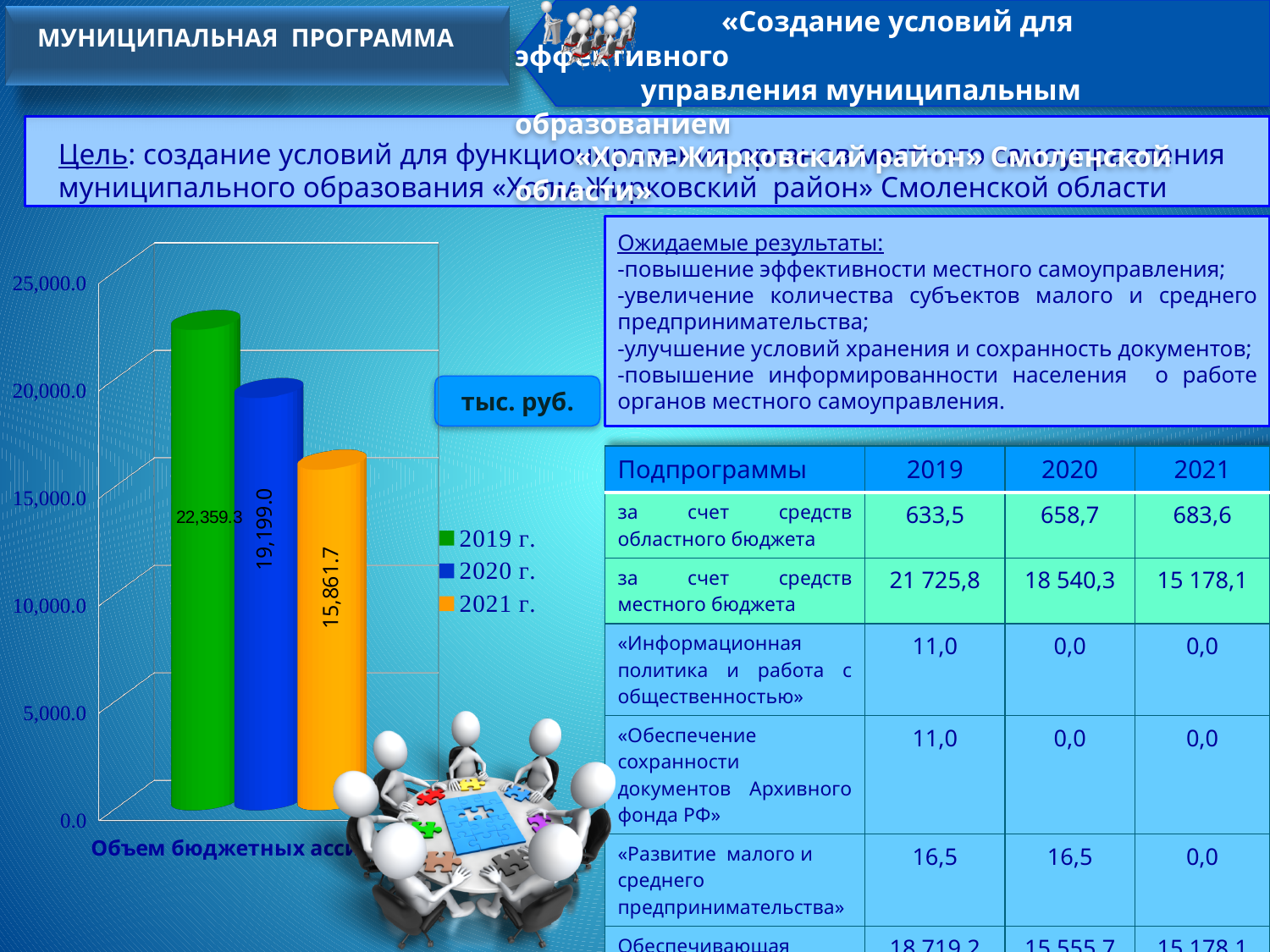
What is the value for 2021 г. in the bar chart? 15,861.7 What is the value for 2019 г. in the bar chart? 22,359.3 What is the value for 2020 г. in the bar chart? 19,199.0 What is the difference between the values for 2019 г. and 2020 г. in the bar chart? 3,160.3 How many bars are plotted in the bar chart? 3 Which is larger in the bar chart, the value for 2020 г. or the value for 2021 г.? 2020 г. What is the difference between the values for 2019 г. and 2021 г. in the bar chart? 6,497.6 How many series does the legend of the bar chart list? 3 Which year has the highest value in the bar chart? 2019 г. Is the value for 2020 г. in the bar chart greater or less than 20,000.0? less Which year has the lowest value in the bar chart? 2021 г. Do the values in the bar chart rise or fall from 2019 г. to 2021 г.? fall